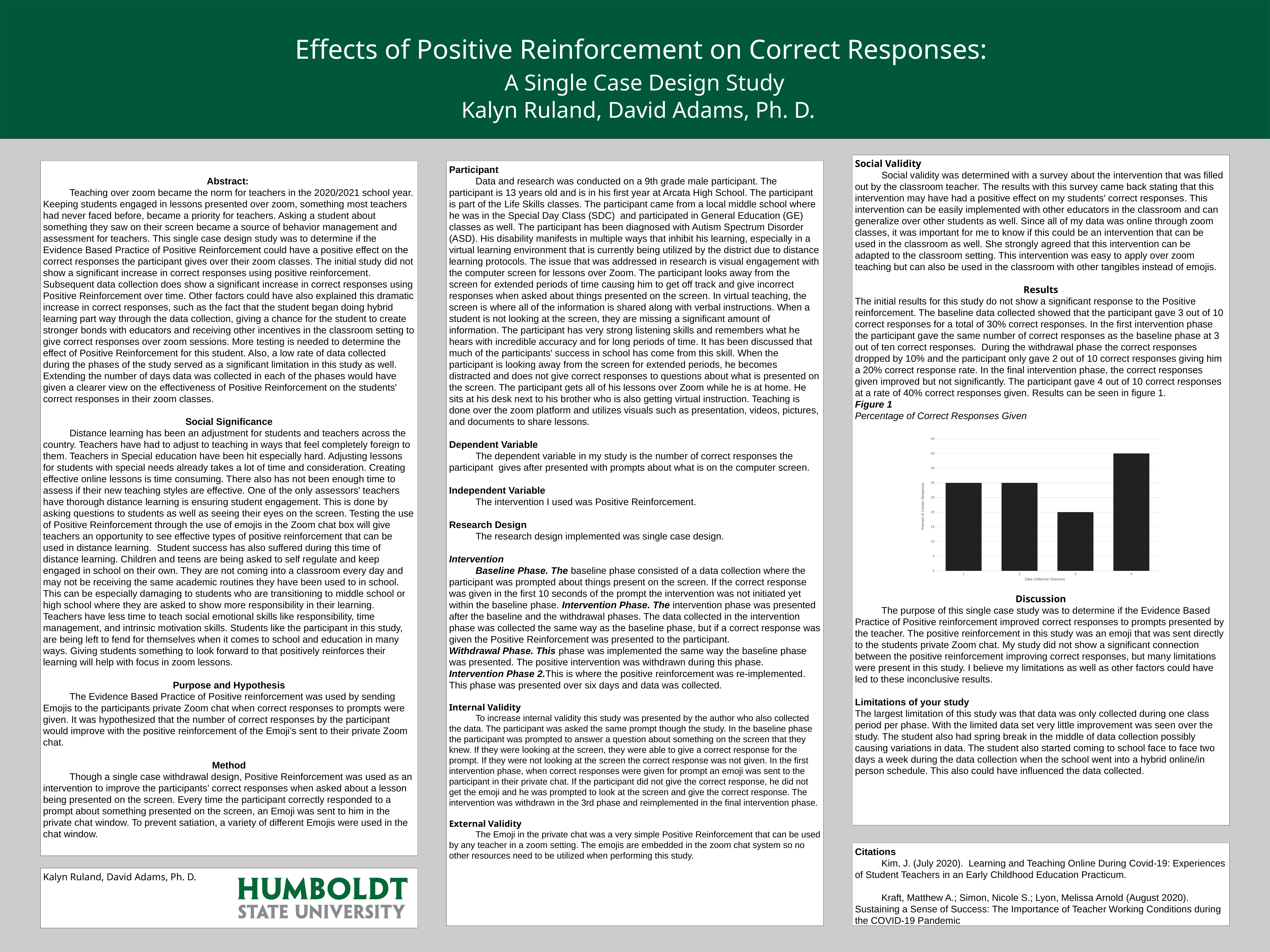
In Figure 1, which has a higher percent of correct responses, session 2 or session 3? session 2 What is the x-axis label of the chart in Figure 1? Data Collection Sessions In Figure 1, what is the percent of correct responses for data collection session 3? 20 In Figure 1, what is the percent of correct responses for data collection session 1? 30 How many data collection sessions are plotted in Figure 1? 4 In Figure 1, which data collection session has the highest percent of correct responses? 4 In Figure 1, is the value for session 4 greater or less than 35? greater In Figure 1, what is the difference in percent of correct responses between session 4 and session 3? 20 In Figure 1, what is the percent of correct responses for data collection session 4? 40 In Figure 1, does the percent of correct responses rise or fall from session 3 to session 4? rise In Figure 1, which data collection session has the lowest percent of correct responses? 3 What kind of chart is Figure 1, Percentage of Correct Responses Given? bar chart